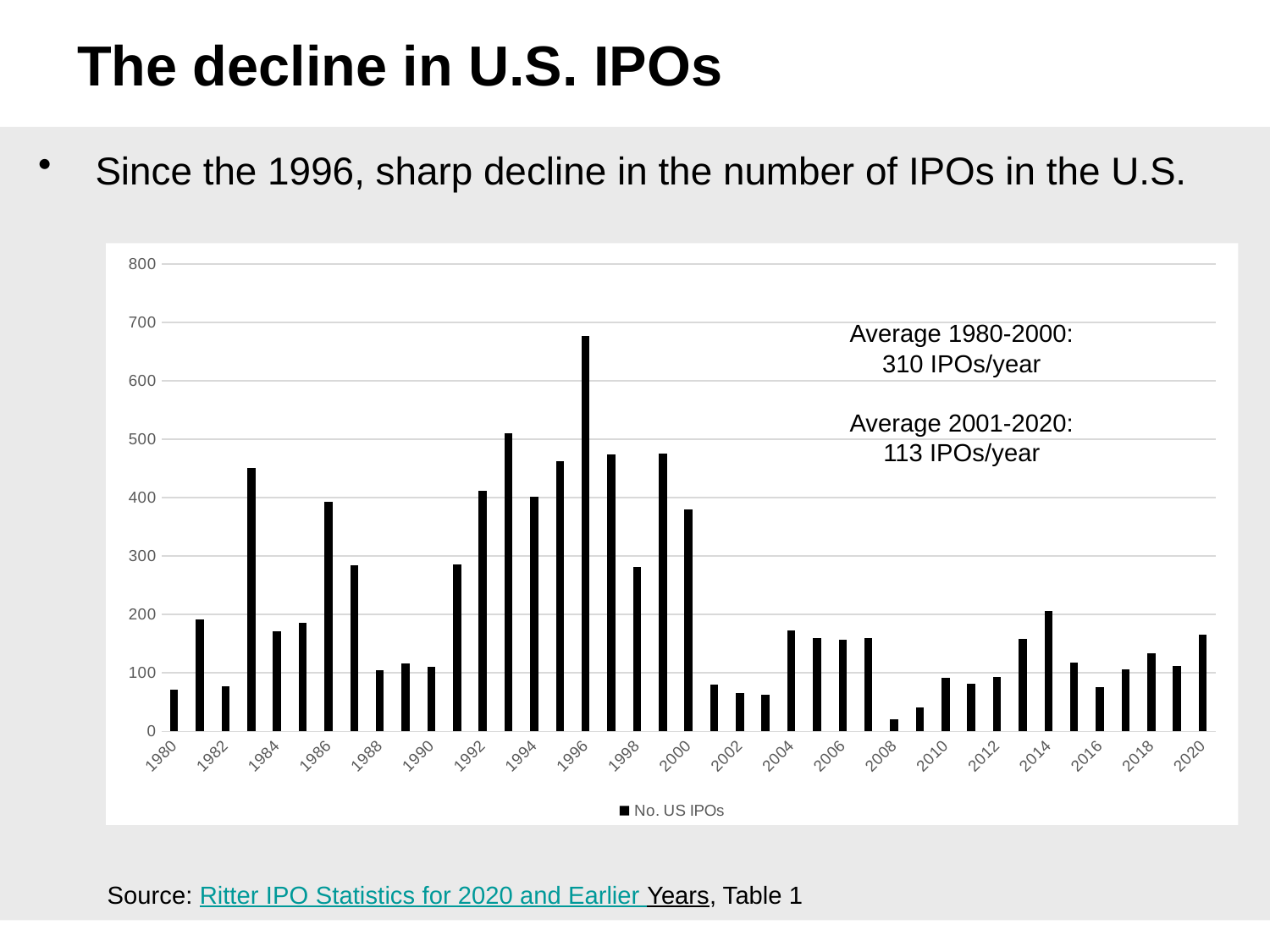
How many series does the legend list? 1 Which year has more U.S. IPOs, 1996 or 1999? 1996 Is the value for 2020 greater or less than 100? greater Is the value for 1983 greater or less than 400? greater Is the value for 2008 greater or less than 100? less Do the values generally rise or fall from 1996 to 2001? fall Which year has the highest number of U.S. IPOs in the chart? 1996 What kind of chart is shown on the slide? bar chart Which year has more U.S. IPOs, 2008 or 2009? 2009 Which year has the lowest number of U.S. IPOs in the chart? 2008 What is the legend entry for the series plotted in the chart? No. US IPOs